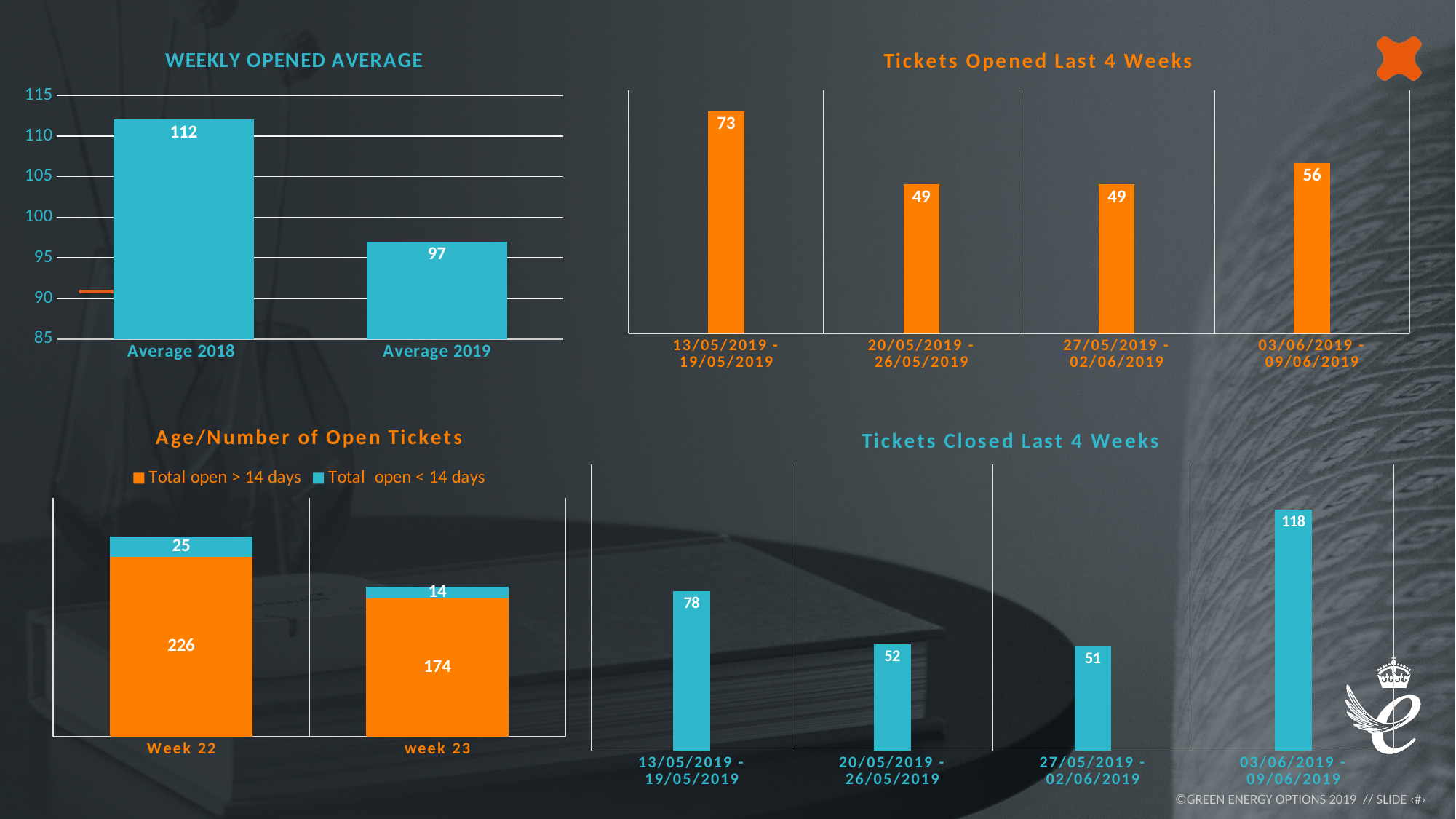
In the 'Tickets Opened Last 4 Weeks' chart, which week has the highest value? 13/05/2019 - 19/05/2019 In the 'Tickets Opened Last 4 Weeks' chart, how many weeks are plotted? 4 In the 'Age/Number of Open Tickets' chart, what is the total of the stacked bar for Week 22? 251 In the 'WEEKLY OPENED AVERAGE' chart, what is the difference between Average 2018 and Average 2019? 15 In the 'Tickets Opened Last 4 Weeks' chart, what is the value for 03/06/2019 - 09/06/2019? 56 In the 'Tickets Closed Last 4 Weeks' chart, which week has the lowest value? 27/05/2019 - 02/06/2019 In the 'Tickets Closed Last 4 Weeks' chart, what is the difference between 03/06/2019 - 09/06/2019 and 13/05/2019 - 19/05/2019? 40 In the 'Tickets Closed Last 4 Weeks' chart, which is larger: the value for 20/05/2019 - 26/05/2019 or the value for 03/06/2019 - 09/06/2019? 03/06/2019 - 09/06/2019 In the 'Age/Number of Open Tickets' chart, how many series does the legend list? 2 What kind of chart is 'Tickets Closed Last 4 Weeks'? Bar chart In the 'Age/Number of Open Tickets' chart, what is the value of 'Total open < 14 days' for week 23? 14 In the 'WEEKLY OPENED AVERAGE' chart, what is the value for Average 2018? 112